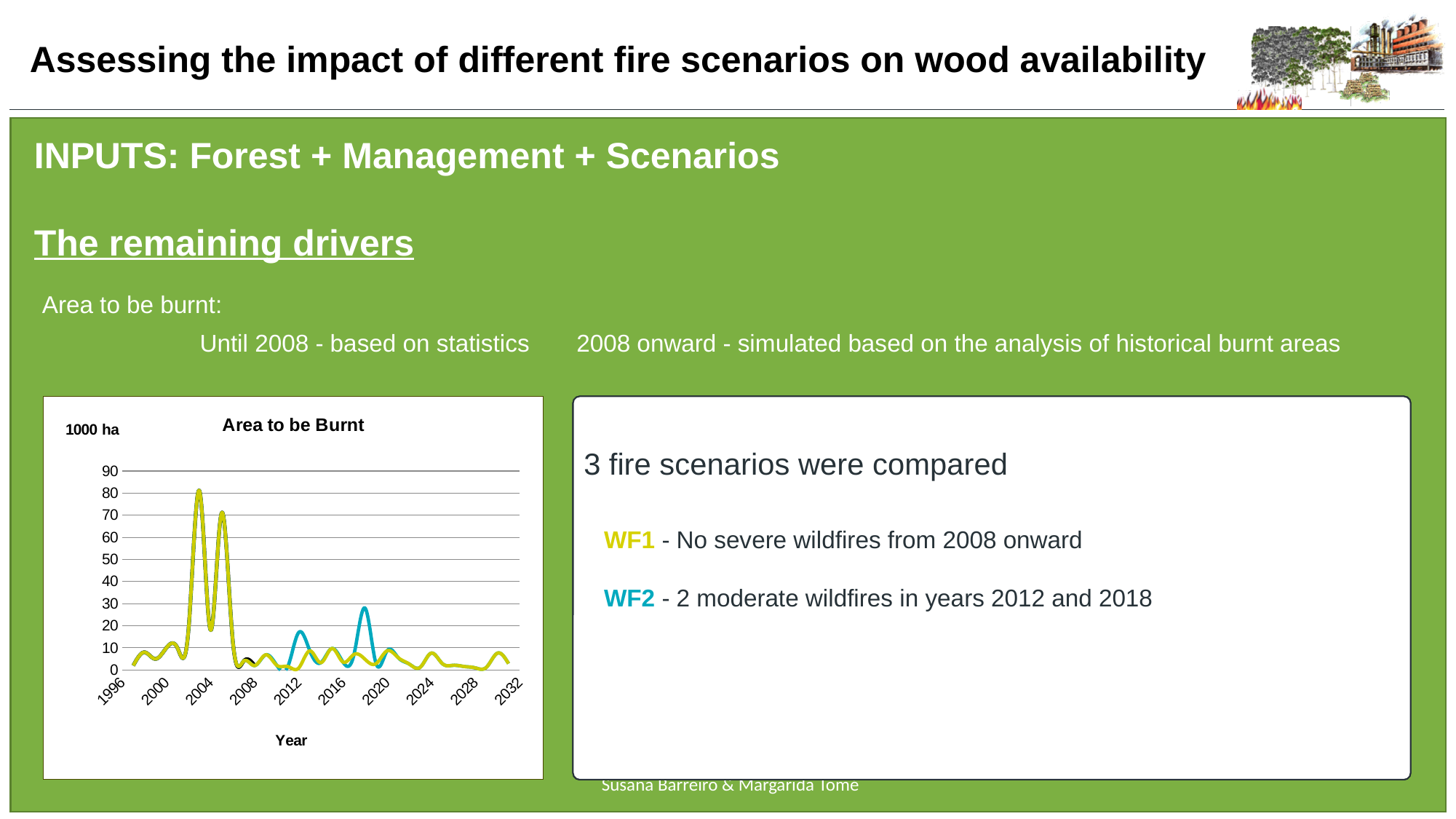
What is the x-axis title of the 'Area to be Burnt' chart? Year In the 'Area to be Burnt' chart, which of the two cyan peaks is higher, the one near 2012 or the one near 2019? the one near 2019 How many year labels are shown on the x-axis of the 'Area to be Burnt' chart? 10 In the 'Area to be Burnt' chart, is the value of the yellow line at 2032 greater or less than 10? less What is the title of the chart on the left of the slide? Area to be Burnt In the 'Area to be Burnt' chart, is the cyan line's peak near 2012 greater or less than 10? greater In the 'Area to be Burnt' chart, is the highest peak (just before 2004) greater or less than 70? greater In the 'Area to be Burnt' chart, does the highest peak occur before or after 2008? before In the 'Area to be Burnt' chart, what is the highest value shown on the y-axis? 90 What kind of chart is 'Area to be Burnt'? line chart